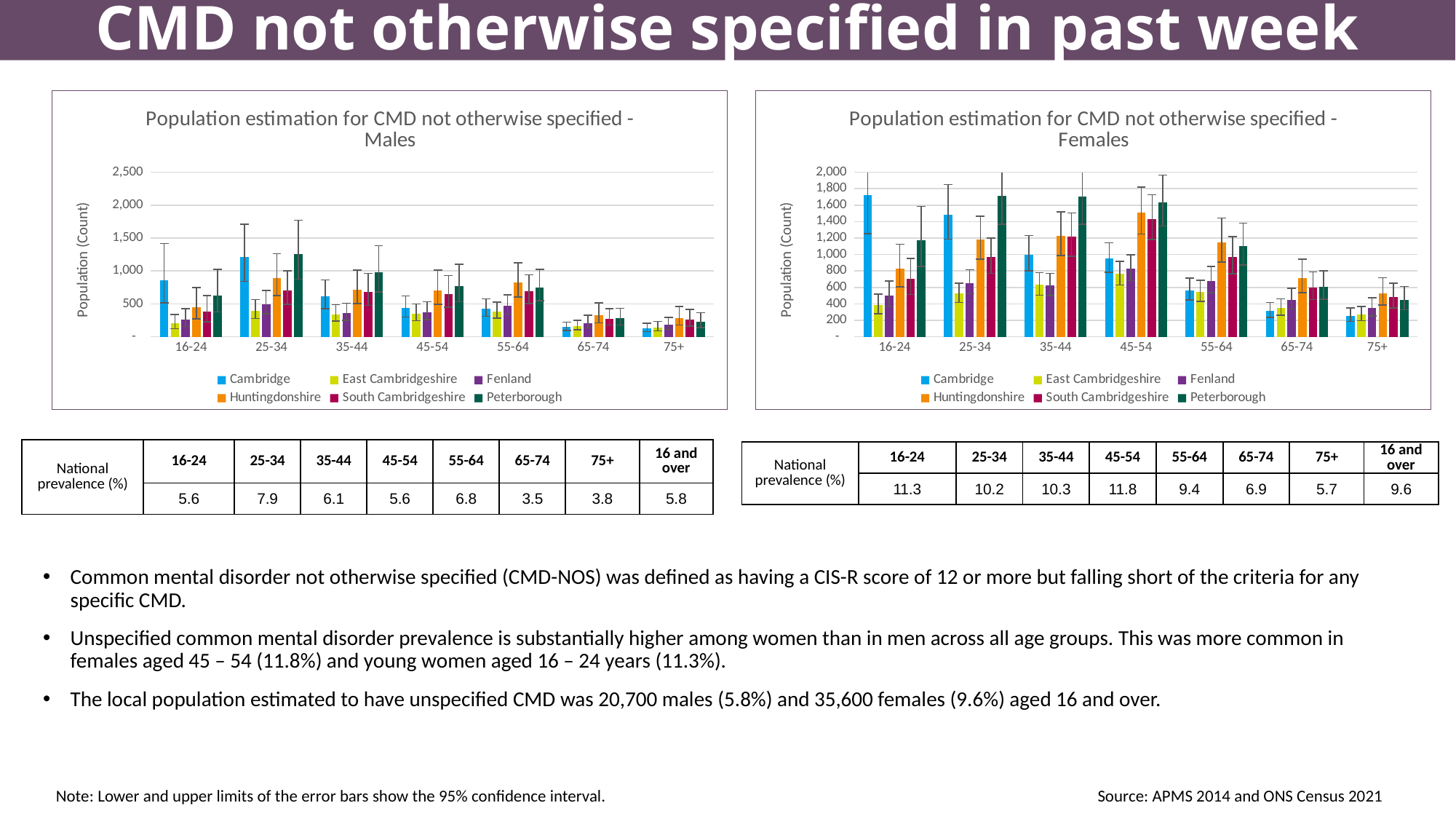
In the Males chart, is the value for Cambridge in the 75+ age group greater or less than 500? less In the Females chart, which district has the highest value in the 25-34 age group? Peterborough In the Females chart, which district has the highest value in the 16-24 age group? Cambridge What is the label on the y axis of the Males chart? Population (Count) In the Females chart, is the value for Cambridge in the 16-24 age group greater or less than 1,400? greater In the Males chart, is the value for Cambridge in the 25-34 age group greater or less than 1,000? greater What kind of chart is the 'Population estimation for CMD not otherwise specified - Males' chart? bar chart How many age-group categories are shown on the x axis of the Females chart? 7 In the Females chart, do the Cambridge bars rise or fall from the 16-24 age group to the 75+ age group? fall How many series does the legend of the Males chart list? 6 In the Males chart, which is larger in the 16-24 age group: Cambridge or Huntingdonshire? Cambridge